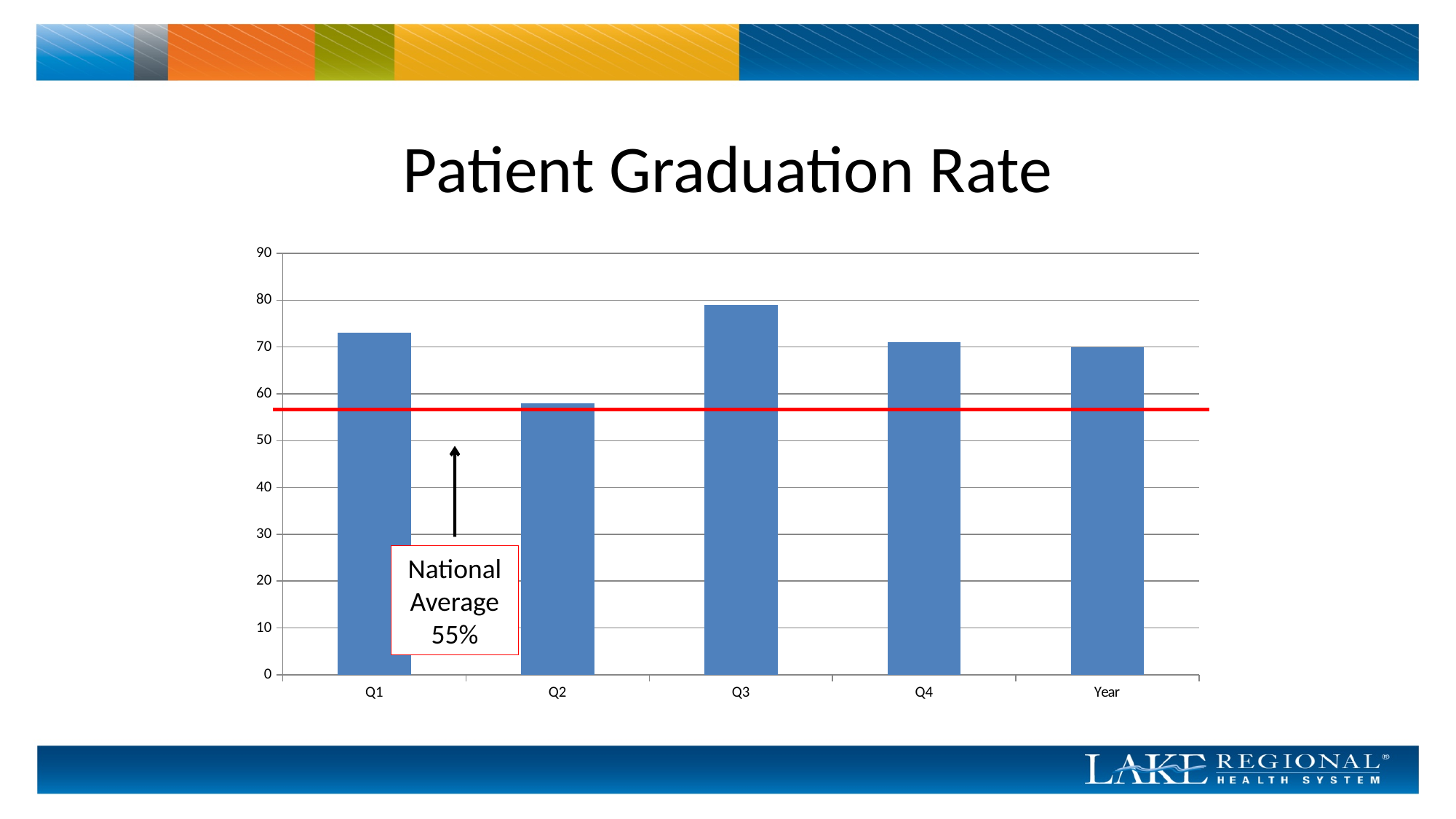
Is the value for Q1 greater or less than 70? greater Is the value for Q2 greater or less than 60? less What kind of chart is shown on the slide? bar chart Which category has the lowest patient graduation rate? Q2 Which category has the highest patient graduation rate? Q3 Is the value for Year greater or less than 60? greater What value does the red horizontal line on the chart represent, according to its label? National Average 55% Which is larger, the value for Q3 or the value for Year? Q3 How many categories are plotted on the x axis? 5 Which is larger, the value for Q1 or the value for Q2? Q1 What is the title of the chart? Patient Graduation Rate